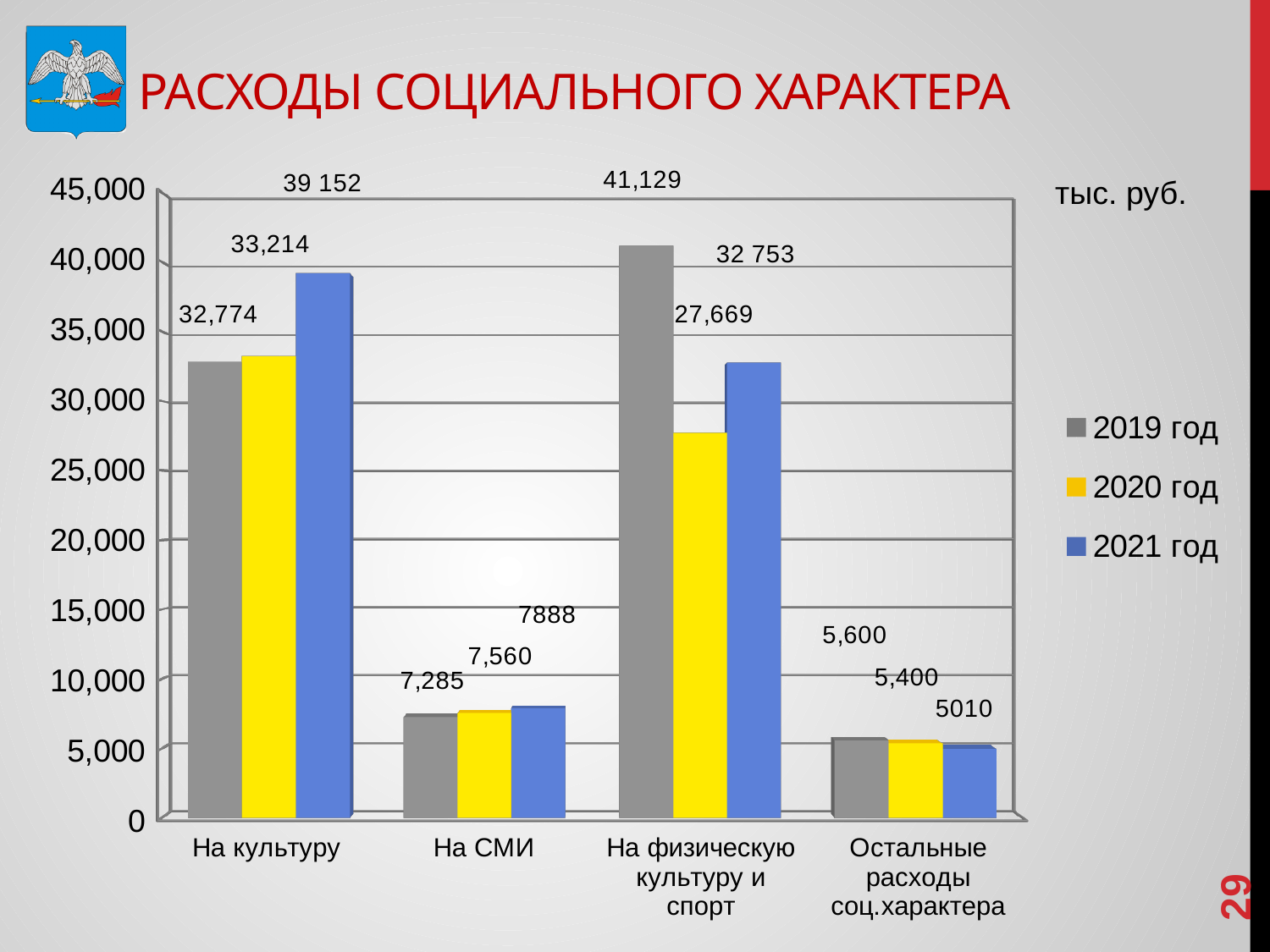
How many categories are shown on the x axis? 4 Which is larger for На культуру: the 2019 год value or the 2020 год value? 2020 год How many series does the legend list? 3 Which category has the lowest value for 2021 год? Остальные расходы соц.характера What unit is indicated next to the chart? тыс. руб. What kind of chart is shown on the slide? Bar chart What is the value for 2021 год in the category На культуру? 39 152 What is the difference between the 2019 год and 2020 год values for На физическую культуру и спорт? 13,460 What is the value for 2019 год in the category На физическую культуру и спорт? 41,129 What is the value for 2021 год in the category Остальные расходы соц.характера? 5010 What is the value for 2020 год in the category На СМИ? 7,560 Which category has the highest value for 2019 год? На физическую культуру и спорт